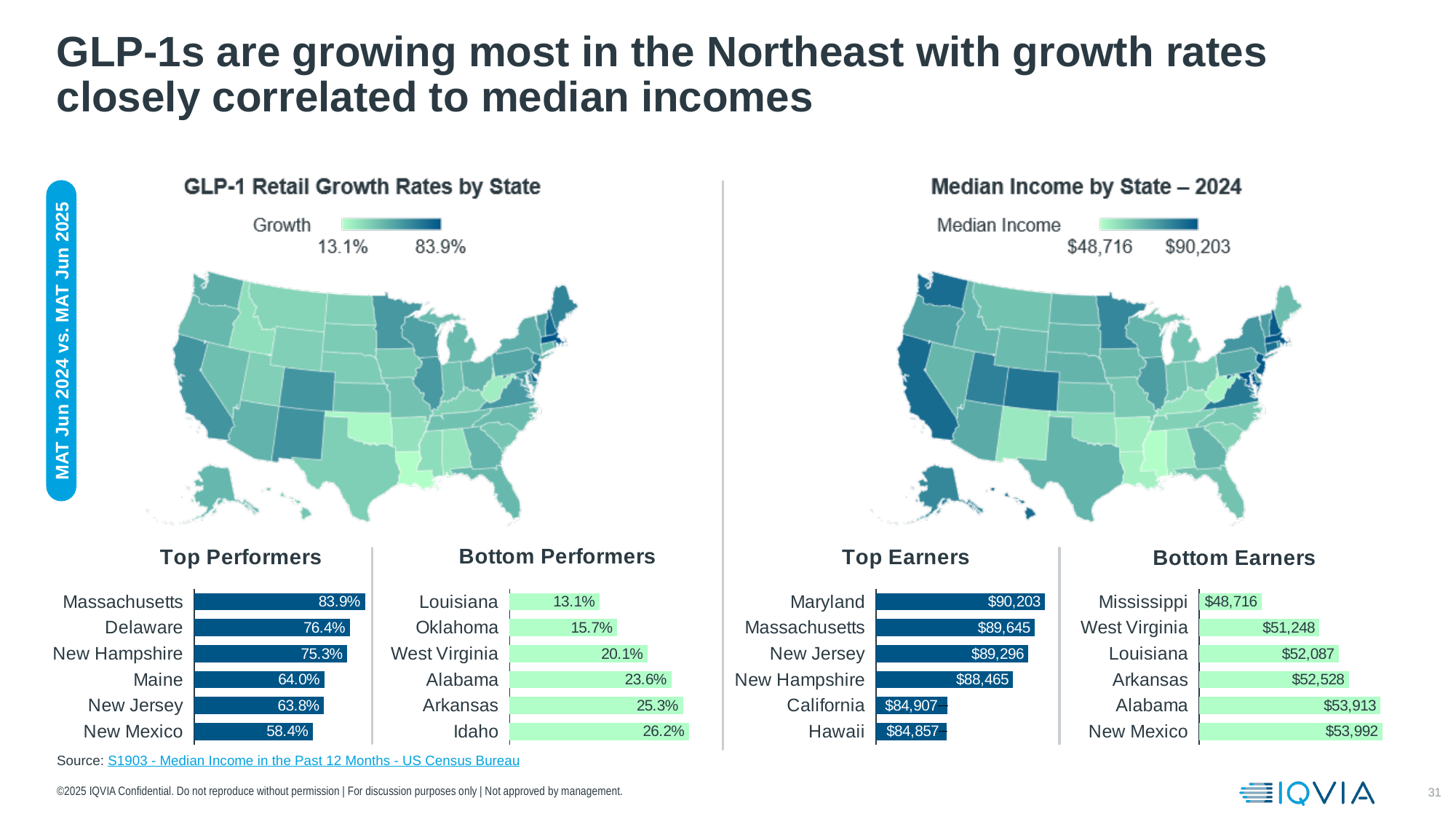
How many states are listed in the Bottom Performers chart? 6 What is the maximum value shown on the Growth legend of the GLP-1 Retail Growth Rates by State map? 83.9% In the Bottom Performers chart, what is the growth rate for Idaho? 26.2% What kind of chart is the Top Earners chart? Bar chart In the Top Performers chart, what is the difference between the growth rates of Massachusetts and Delaware? 7.5% In the Bottom Earners chart, which state has the highest median income shown? New Mexico In the Top Earners chart, what is the difference in median income between Maryland and Massachusetts? $558 In the Top Earners chart, what is the median income for Maryland? $90,203 In the Top Performers chart, what is the GLP-1 retail growth rate for Massachusetts? 83.9% In the Top Earners chart, which has a higher median income, California or Hawaii? California In the Bottom Earners chart, what is the median income for Mississippi? $48,716 In the Bottom Performers chart, which state has the lowest growth rate? Louisiana